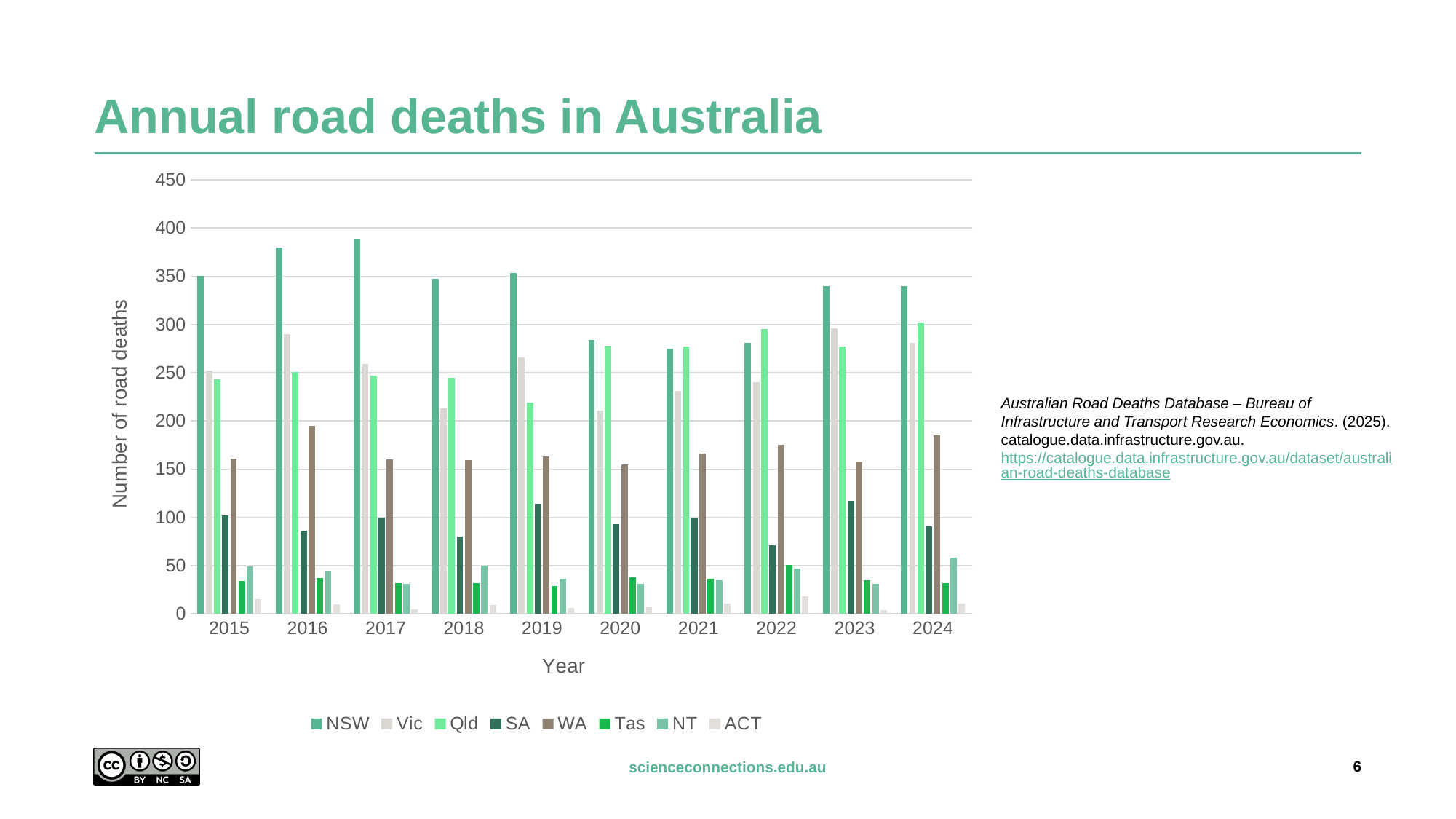
Which state or territory has the lowest number of road deaths in 2015? ACT In 2024, which is larger, the value for NT or the value for Tas? NT What kind of chart is shown on the slide? bar chart In 2024, which is larger, the value for Qld or the value for Vic? Qld Is the value for NSW in 2016 greater or less than 350? greater Is the value for Qld in 2022 greater or less than 250? greater What is the label on the y axis? Number of road deaths How many years are shown on the x axis? 10 How many series does the legend list? 8 Which state or territory has the highest number of road deaths in 2017? NSW Is the value for Vic in 2018 greater or less than 250? less